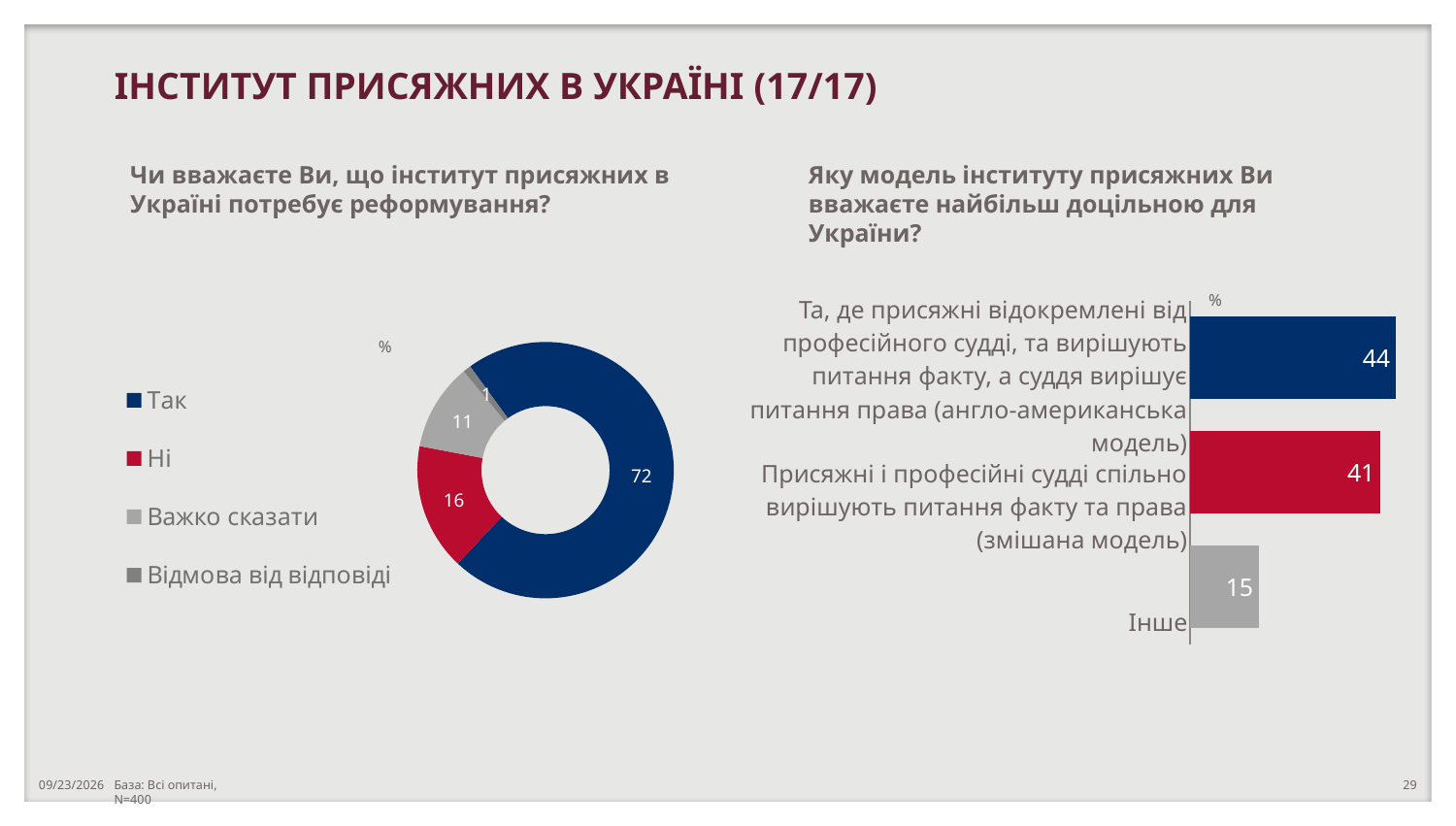
In the left chart ("Чи вважаєте Ви, що інститут присяжних в Україні потребує реформування?"), what is the difference between the values for "Так" and "Ні"? 56 In the left chart ("Чи вважаєте Ви, що інститут присяжних в Україні потребує реформування?"), what is the value for "Так"? 72 In the right chart ("Яку модель інституту присяжних Ви вважаєте найбільш доцільною для України?"), what is the value for the англо-американська модель? 44 In the left chart ("Чи вважаєте Ви, що інститут присяжних в Україні потребує реформування?"), how many categories does the legend list? 4 What type of chart is the right chart ("Яку модель інституту присяжних Ви вважаєте найбільш доцільною для України?")? Bar chart In the right chart ("Яку модель інституту присяжних Ви вважаєте найбільш доцільною для України?"), what is the value for "Інше"? 15 What type of chart is the left chart ("Чи вважаєте Ви, що інститут присяжних в Україні потребує реформування?")? Pie (doughnut) chart In the left chart ("Чи вважаєте Ви, що інститут присяжних в Україні потребує реформування?"), which category has the largest share? Так In the left chart ("Чи вважаєте Ви, що інститут присяжних в Україні потребує реформування?"), what is the value for "Важко сказати"? 11 In the right chart ("Яку модель інституту присяжних Ви вважаєте найбільш доцільною для України?"), what is the difference between the values for the англо-американська модель and the змішана модель? 3 In the right chart ("Яку модель інституту присяжних Ви вважаєте найбільш доцільною для України?"), which category has the lowest value? Інше In the left chart ("Чи вважаєте Ви, що інститут присяжних в Україні потребує реформування?"), what is the value for "Ні"? 16